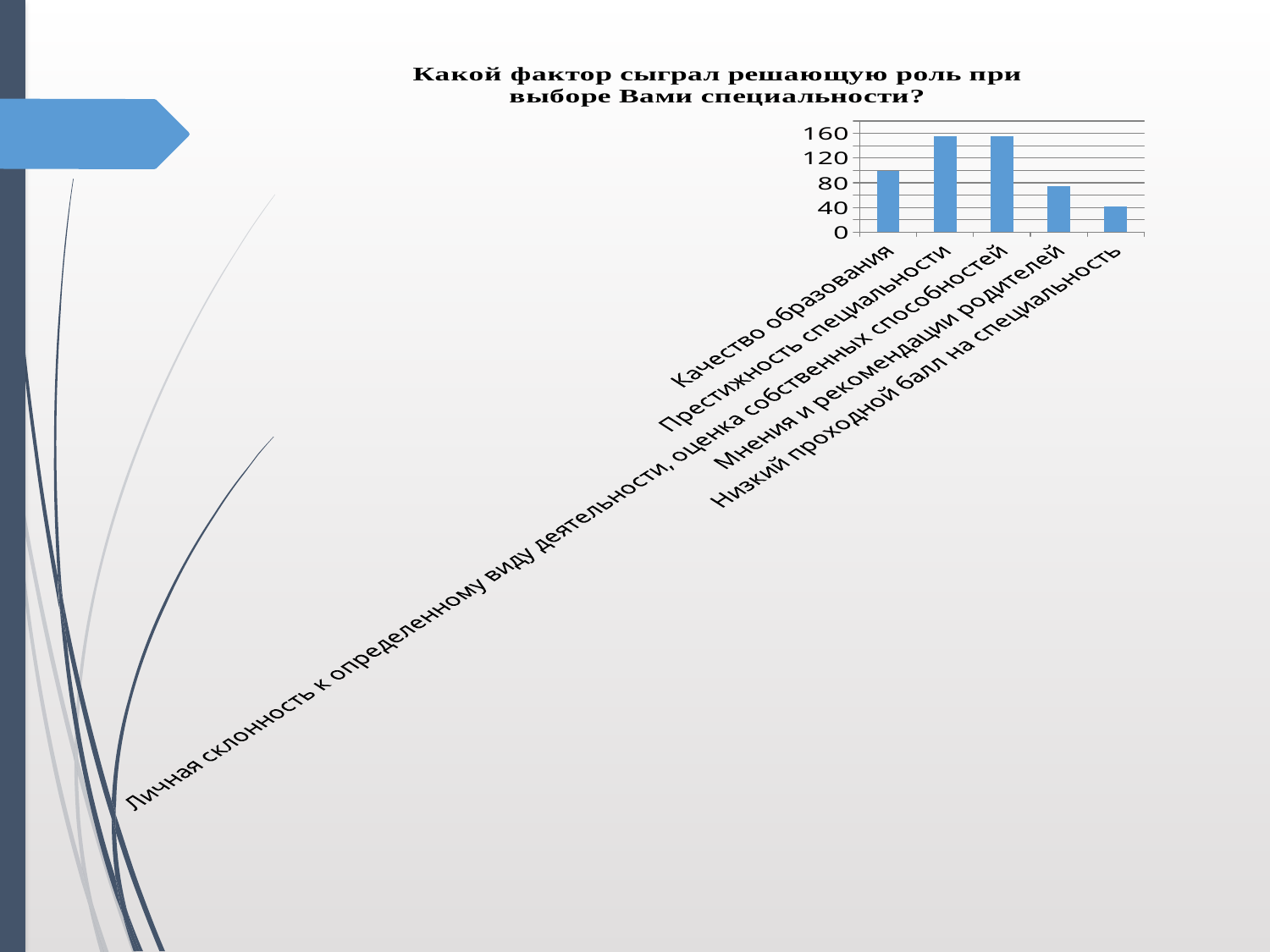
Is the value for Престижность специальности greater or less than 120? greater Which category has the lowest value? Низкий проходной балл на специальность What kind of chart is shown on the slide? bar chart Is the value for Качество образования greater or less than 120? less Is the value for Качество образования greater or less than 80? greater What is the title of the chart? Какой фактор сыграл решающую роль при выборе Вами специальности? What is the highest value shown on the vertical axis? 160 Which is larger: the value for Качество образования or the value for Мнения и рекомендации родителей? Качество образования How many categories (bars) does the chart show? 5 Which is larger: the value for Престижность специальности or the value for Качество образования? Престижность специальности